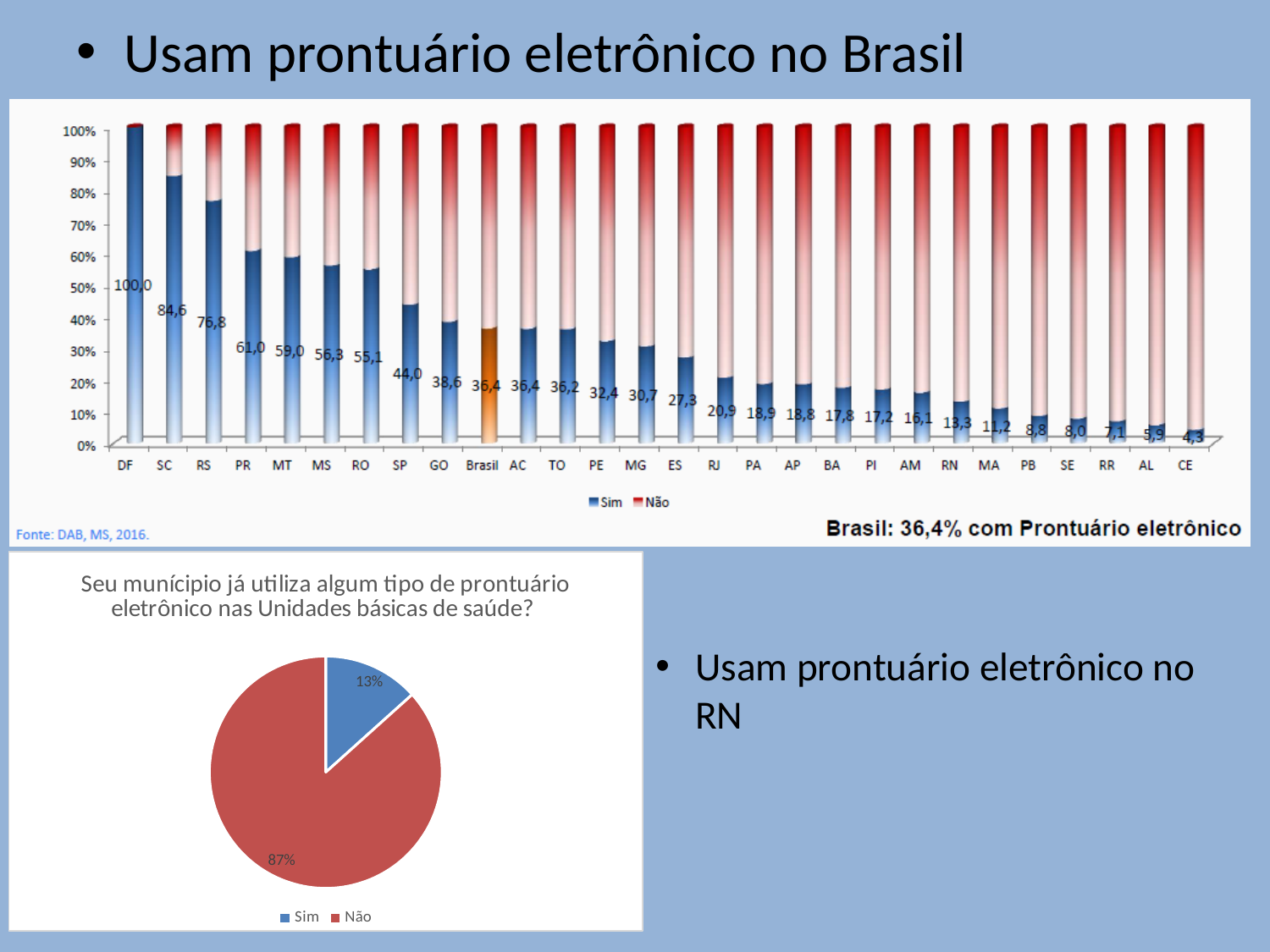
In the top bar chart, how many series does the legend list? 2 In the top bar chart, which category has the lowest 'Sim' value? CE In the bottom-left pie chart, what is the value for 'Sim'? 13% In the top bar chart, what is the 'Sim' value for RN? 13,3 In the top bar chart, how many categories are shown on the x axis? 28 In the top bar chart, what is the 'Sim' value for Brasil? 36,4 What kind of chart is the top chart on the slide? Stacked bar chart In the top bar chart, which has a larger 'Sim' value, SP or GO? SP In the bottom-left pie chart, what share does 'Não' have? 87% In the top bar chart, what is the difference between the 'Sim' values for SC and RS? 7,8 In the top bar chart, which category has the highest 'Sim' value? DF In the bottom-left pie chart, which slice is larger, 'Sim' or 'Não'? Não